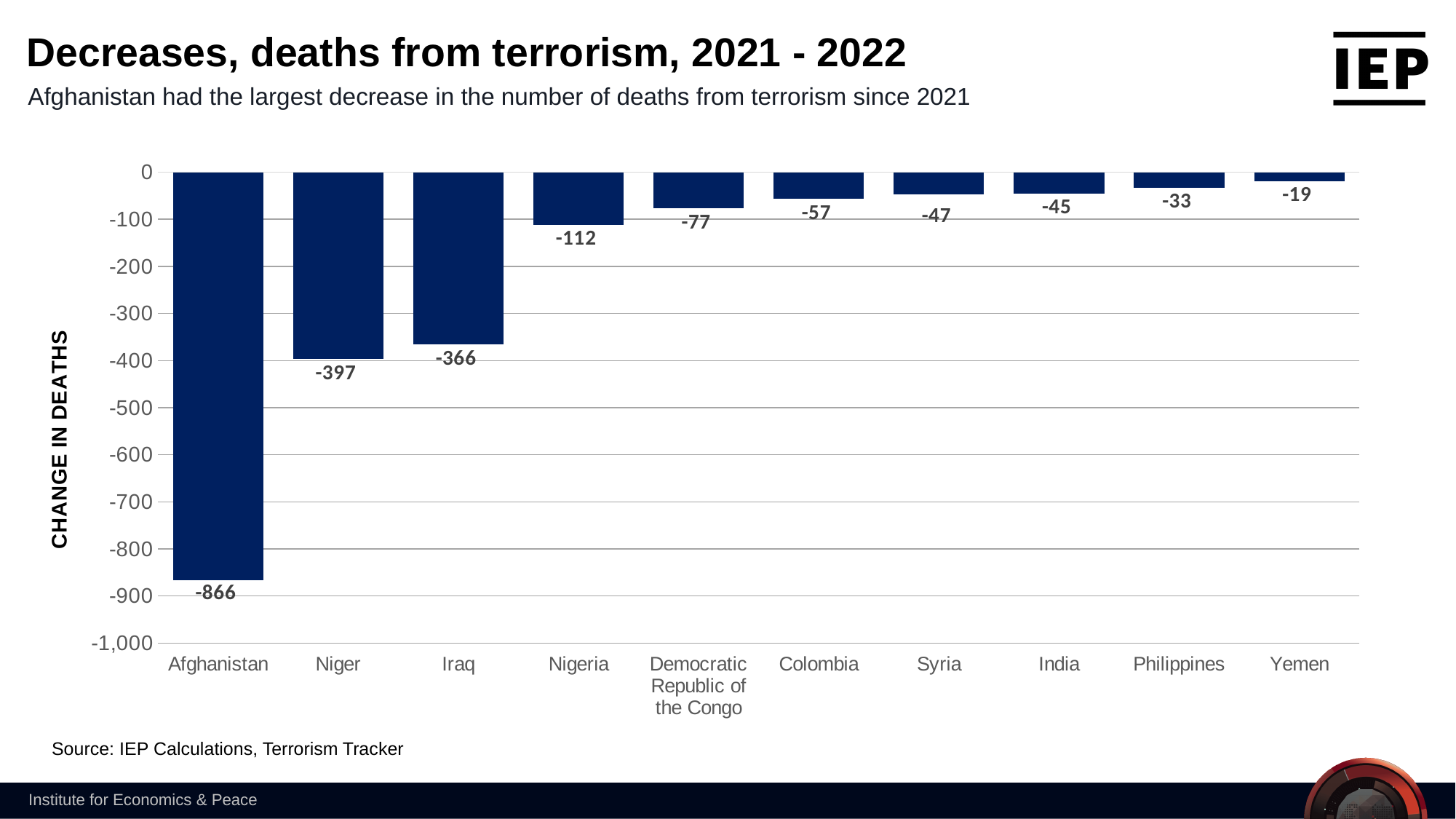
What value is shown for the Democratic Republic of the Congo? -77 Which country had the smallest decrease in deaths from terrorism? Yemen What is the label of the vertical axis? CHANGE IN DEATHS How many countries are shown in the chart? 10 Which country had a larger decrease in deaths, Nigeria or Colombia? Nigeria Which country had the largest decrease in deaths from terrorism? Afghanistan What is the change in deaths shown for Yemen? -19 What is the change in deaths shown for Niger? -397 What is the change in deaths shown for Afghanistan? -866 What is the source cited for the chart? IEP Calculations, Terrorism Tracker What is the difference between the values for Niger and Iraq? 31 What type of chart is shown on the slide? Bar chart